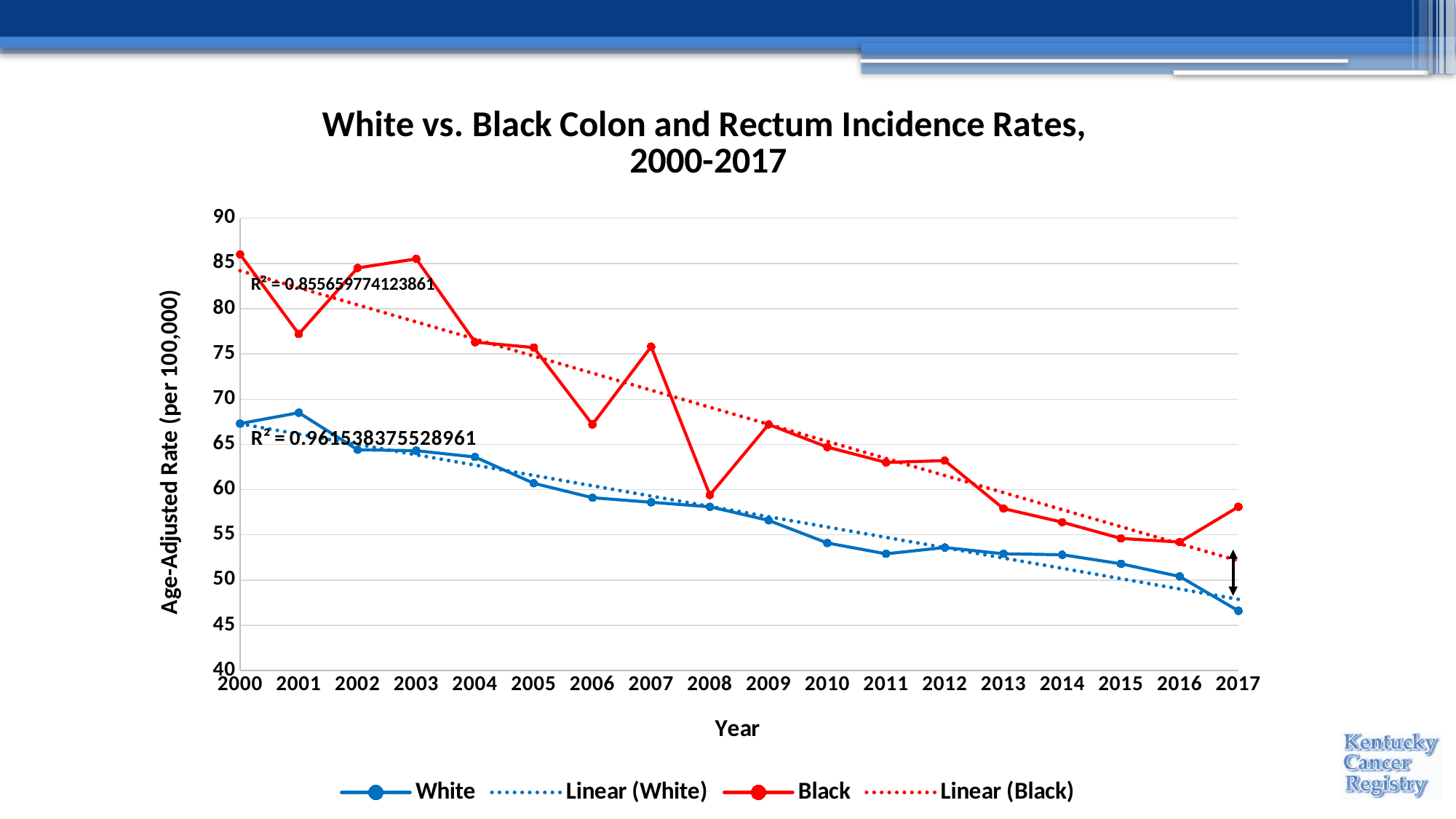
Does the White incidence rate generally rise or fall from 2000 to 2017? Fall What kind of chart is shown on the slide? Line chart Which series has the higher incidence rate in 2017, White or Black? Black What is the label on the y axis? Age-Adjusted Rate (per 100,000) What is the R² value shown for the White linear trendline? 0.961538375528961 Is the Black incidence rate in 2000 greater or less than 85? greater In which year is the White incidence rate lowest? 2017 Is the White incidence rate in 2017 greater or less than 50? less In which year is the White incidence rate highest? 2001 How many entries does the legend list? 4 How many years are plotted along the x axis? 18